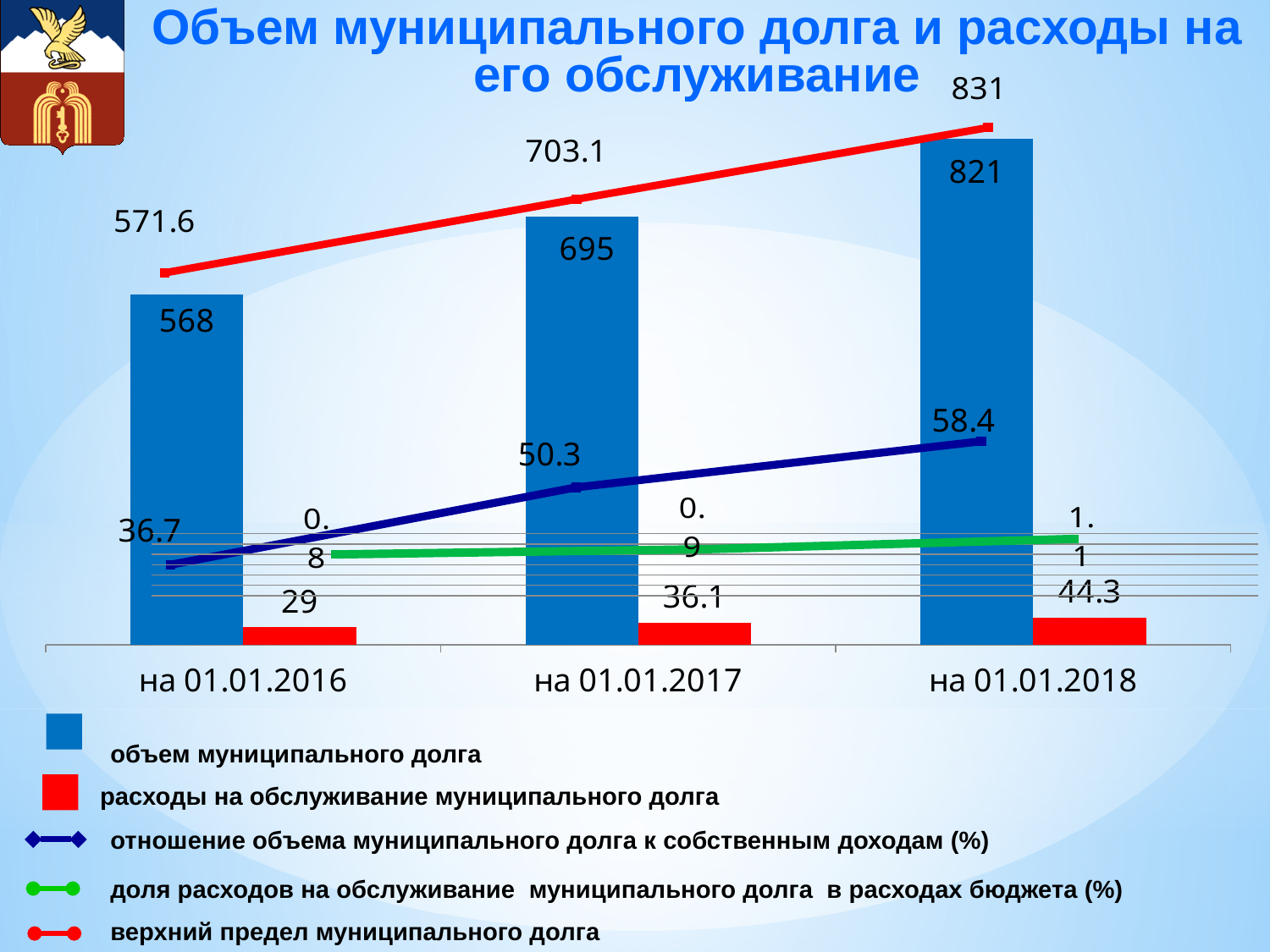
What is the value of объем муниципального долга на 01.01.2016? 568 On which date is объем муниципального долга the highest? на 01.01.2018 What is the difference between объем муниципального долга на 01.01.2018 and на 01.01.2016? 253 What is the value of отношение объема муниципального долга к собственным доходам (%) на 01.01.2018? 58.4 Which is larger: верхний предел муниципального долга на 01.01.2016 or объем муниципального долга на 01.01.2017? объем муниципального долга на 01.01.2017 How many dates (categories) are shown on the x axis? 3 How many series does the legend list? 5 What is the value of верхний предел муниципального долга на 01.01.2017? 703.1 On which date is расходы на обслуживание муниципального долга the lowest? на 01.01.2016 What is the value of объем муниципального долга на 01.01.2018? 821 What is the value of расходы на обслуживание муниципального долга на 01.01.2017? 36.1 Does объем муниципального долга rise or fall from 01.01.2016 to 01.01.2018? rise